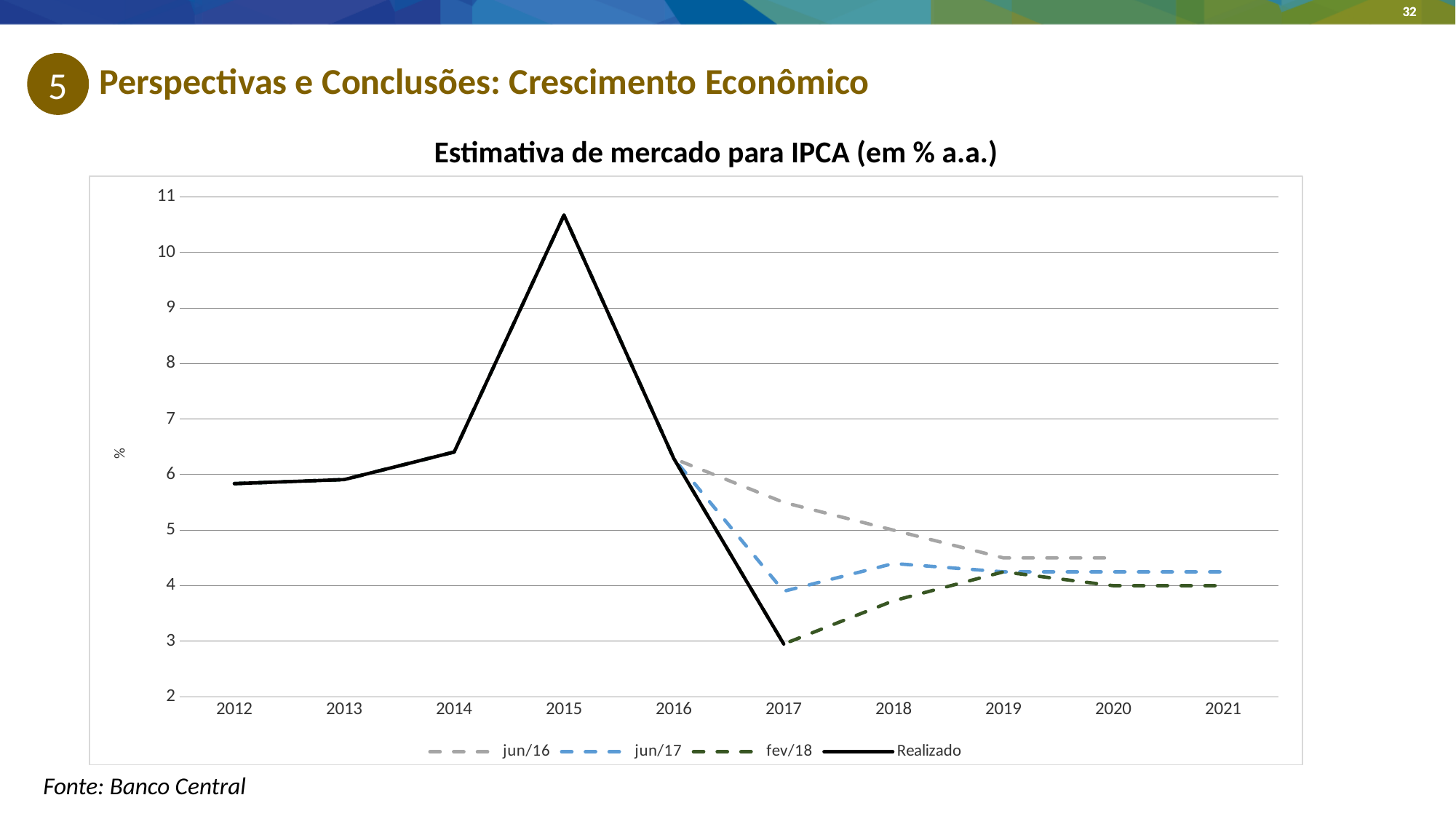
How many series does the legend list? 4 How many years are shown on the x axis? 10 In 2018, which series has the larger value, jun/16 or fev/18? jun/16 In which year does the Realizado series reach its highest value? 2015 Is the Realizado value for 2017 greater or less than 4? less What kind of chart is shown on the slide? line chart Is the Realizado value for 2015 greater or less than 10? greater What is the title of the chart? Estimativa de mercado para IPCA (em % a.a.) Does the Realizado series rise or fall between 2015 and 2017? fall Is the jun/16 value for 2018 greater or less than 6? less In which year does the Realizado series reach its lowest value? 2017